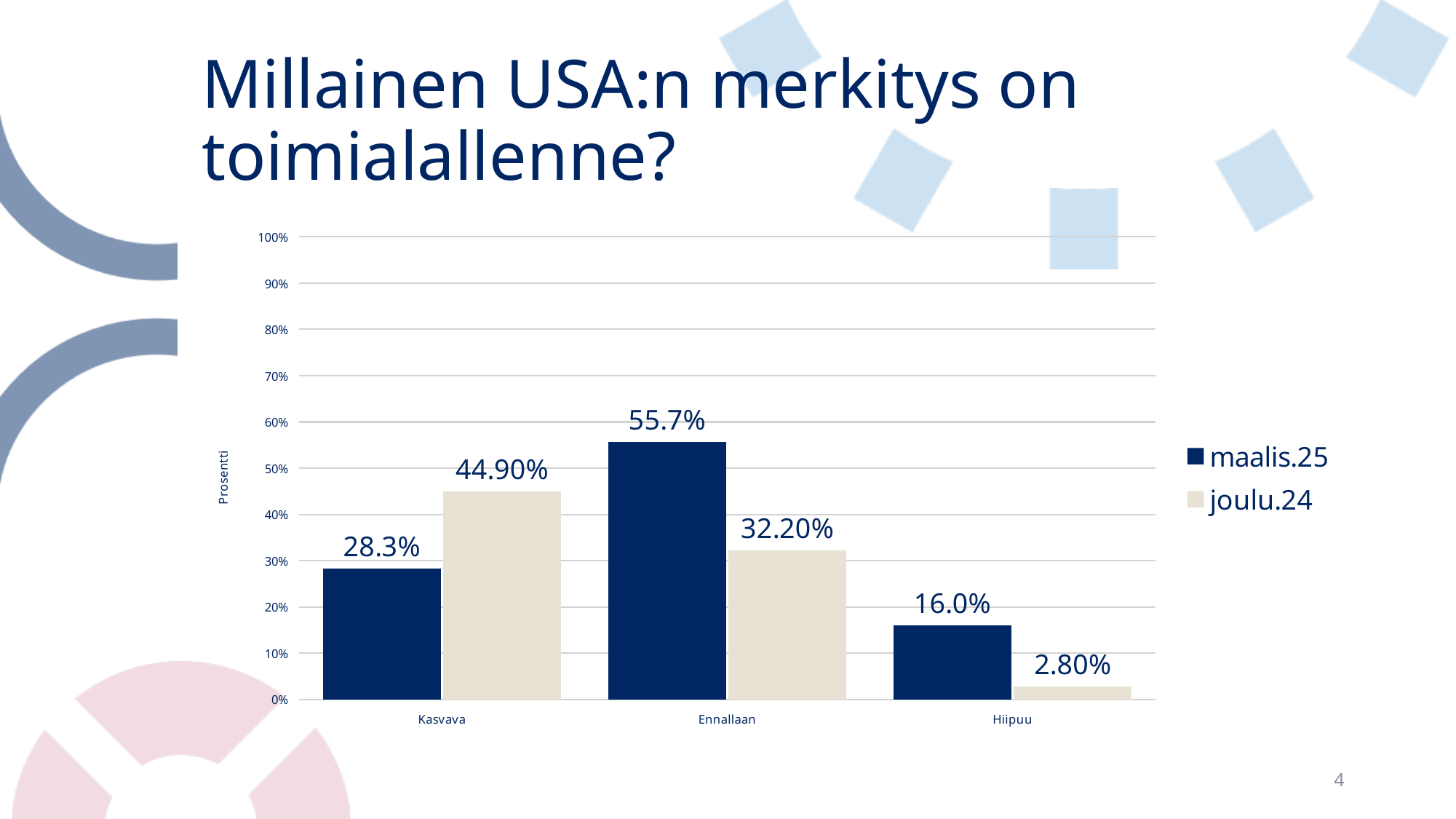
What is the value for Hiipuu in the joulu.24 series? 2.80% For Kasvava, which series has the larger value, maalis.25 or joulu.24? joulu.24 What is the value for Ennallaan in the joulu.24 series? 32.20% How many series does the legend list? 2 What is the value for Kasvava in the maalis.25 series? 28.3% How many categories are shown on the x axis? 3 What is the difference between the maalis.25 and joulu.24 values for Ennallaan? 23.5 percentage points Which category has the lowest value in the joulu.24 series? Hiipuu What is the label of the vertical axis? Prosentti Which category has the highest value in the maalis.25 series? Ennallaan What is the value for Hiipuu in the maalis.25 series? 16.0% What kind of chart is shown on the slide? Bar chart